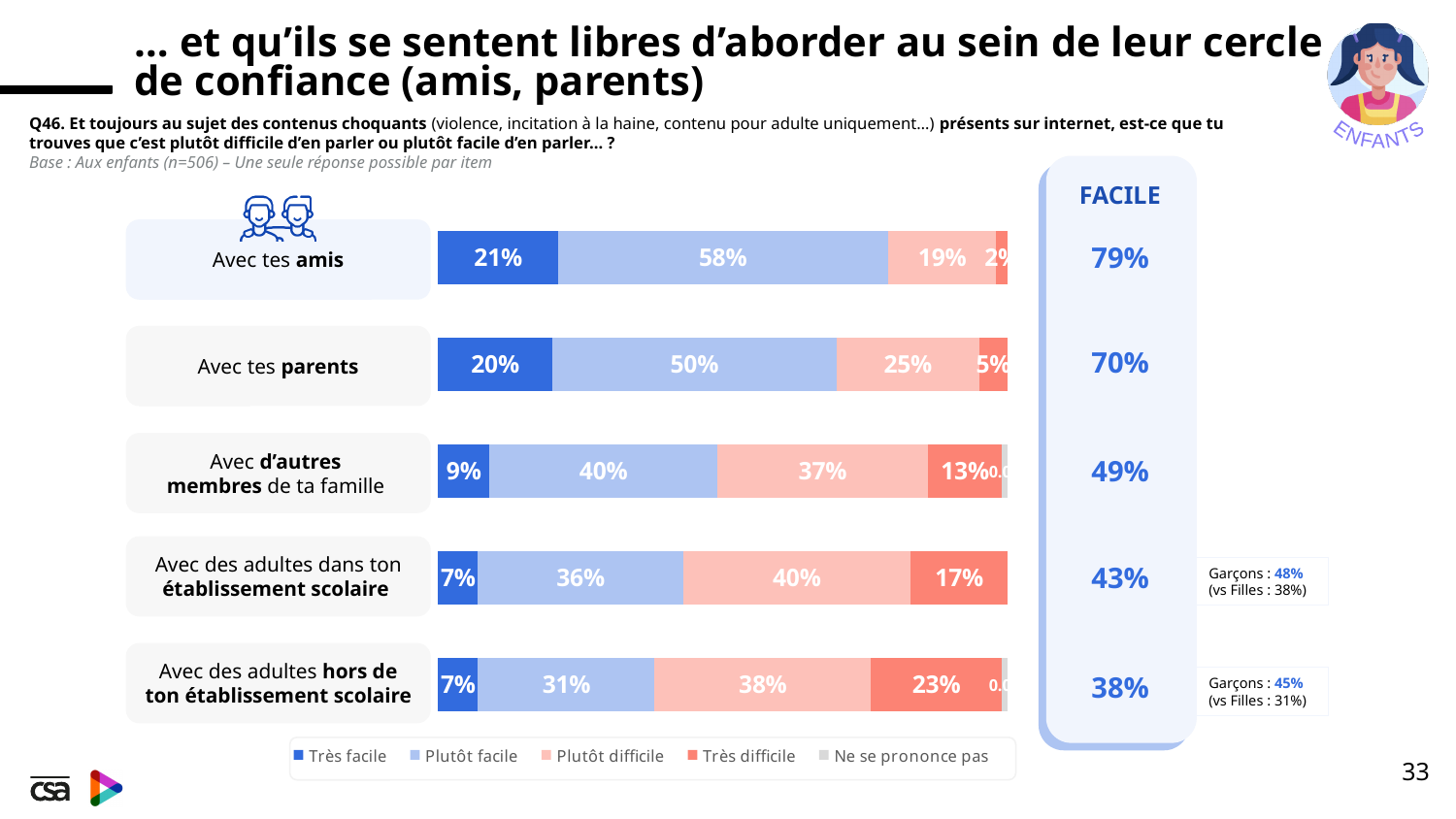
What percentage of children say it is "Très facile" to talk about shocking content with their friends (Avec tes amis)? 21% Is the "Très difficile" value larger for "Avec tes parents" or for "Avec d'autres membres de ta famille"? Avec d'autres membres de ta famille What kind of chart is shown on the slide? Stacked bar chart What is the "Très difficile" value for "Avec des adultes hors de ton établissement scolaire"? 23% Which category has the lowest "Plutôt facile" value? Avec des adultes hors de ton établissement scolaire What is the "Plutôt difficile" value for "Avec des adultes dans ton établissement scolaire"? 40% What is the difference between the "Plutôt facile" values for "Avec tes amis" and "Avec tes parents"? 8% What is the FACILE total shown for "Avec d'autres membres de ta famille"? 49% How many categories (rows) are shown in the chart? 5 Which category has the highest "Très facile" value? Avec tes amis What is the "Plutôt facile" value for "Avec tes parents"? 50% How many series does the legend list? 5